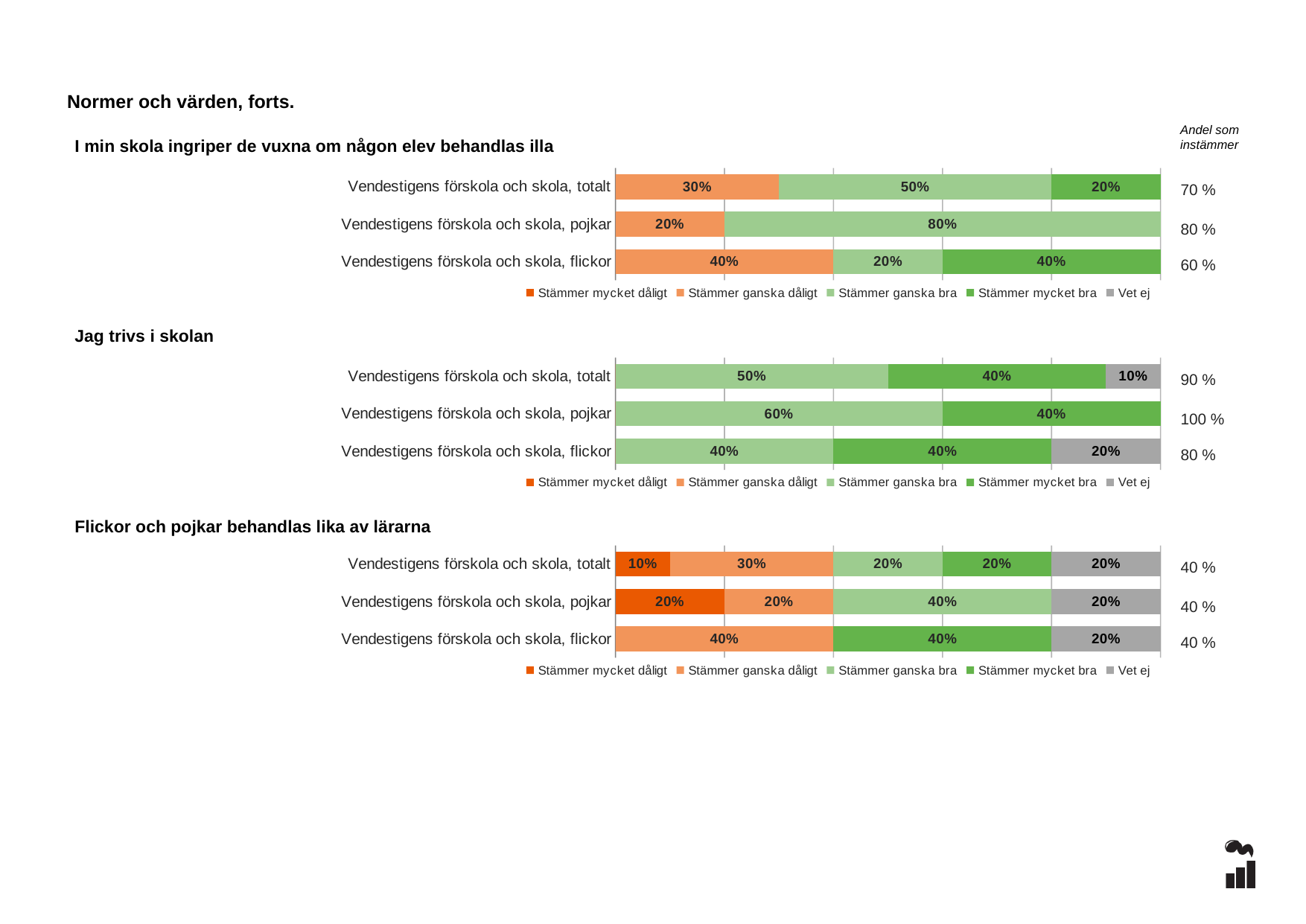
In the chart 'Flickor och pojkar behandlas lika av lärarna', which is larger for 'Vendestigens förskola och skola, totalt': 'Stämmer ganska dåligt' or 'Stämmer mycket dåligt'? Stämmer ganska dåligt How many series does the legend of the chart 'Jag trivs i skolan' list? 5 In the chart 'Jag trivs i skolan', what share of 'Vendestigens förskola och skola, totalt' answered 'Vet ej'? 10% In the chart 'Jag trivs i skolan', what is the 'Andel som instämmer' value for 'Vendestigens förskola och skola, pojkar'? 100 % In the chart 'I min skola ingriper de vuxna om någon elev behandlas illa', which row has the highest 'Andel som instämmer'? Vendestigens förskola och skola, pojkar What type of chart is 'I min skola ingriper de vuxna om någon elev behandlas illa'? Stacked bar chart In the chart 'I min skola ingriper de vuxna om någon elev behandlas illa', what is the 'Andel som instämmer' value for 'Vendestigens förskola och skola, flickor'? 60 % In the chart 'Flickor och pojkar behandlas lika av lärarna', what share of 'Vendestigens förskola och skola, pojkar' answered 'Stämmer mycket dåligt'? 20% In the chart 'I min skola ingriper de vuxna om någon elev behandlas illa', what share of 'Vendestigens förskola och skola, pojkar' answered 'Stämmer ganska bra'? 80% In the chart 'Flickor och pojkar behandlas lika av lärarna', how many rows (categories) are shown? 3 In the chart 'Jag trivs i skolan', what is the difference between the 'Stämmer ganska bra' shares for 'pojkar' and 'flickor'? 20% In the chart 'Jag trivs i skolan', which row has the lowest 'Andel som instämmer'? Vendestigens förskola och skola, flickor